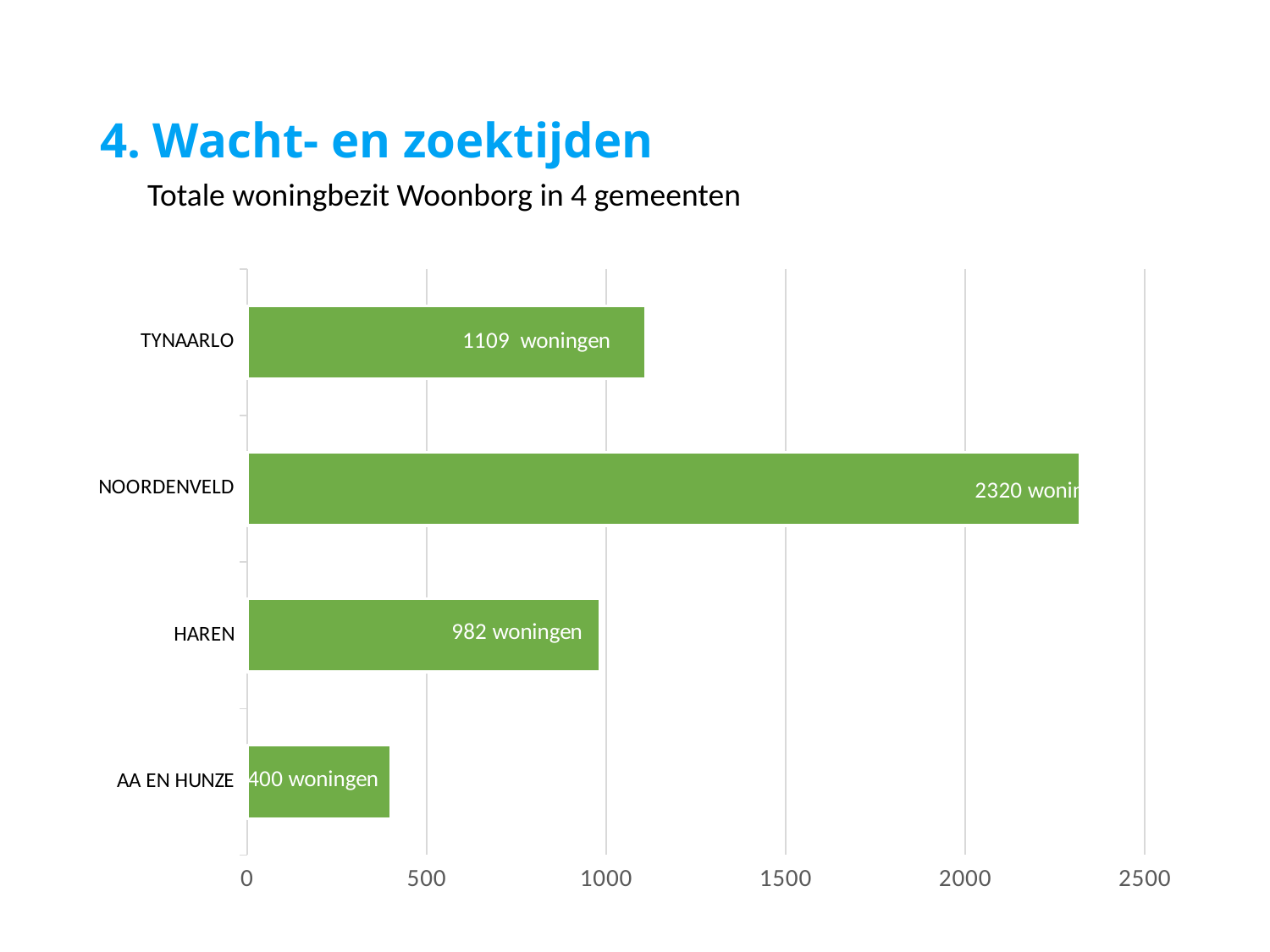
What kind of chart is shown on the slide? Bar chart What is the value shown for AA EN HUNZE? 400 woningen Which has more woningen, TYNAARLO or HAREN? TYNAARLO Is the value for NOORDENVELD greater or less than 2000? greater How many woningen does the chart show for TYNAARLO? 1109 woningen How many gemeenten are shown in the chart? 4 Which gemeente has the highest number of woningen? NOORDENVELD Which gemeente has the lowest number of woningen? AA EN HUNZE What is the difference in woningen between NOORDENVELD and AA EN HUNZE? 1920 What is the title of the chart? Totale woningbezit Woonborg in 4 gemeenten What is the value shown for HAREN? 982 woningen What is the difference in woningen between TYNAARLO and HAREN? 127